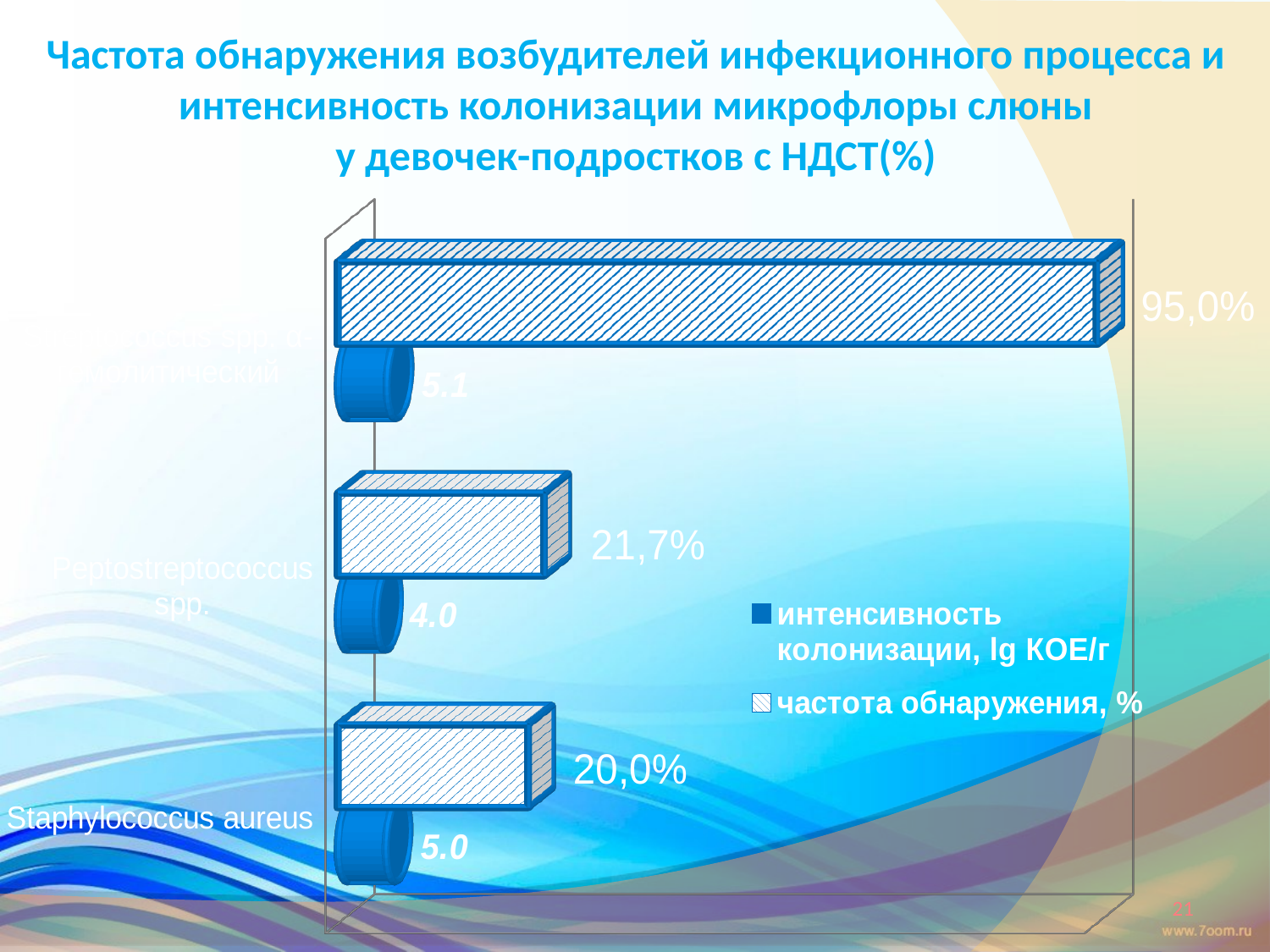
What is the difference in частота обнаружения, % between Peptostreptococcus spp. and Staphylococcus aureus? 1,7% What is the частота обнаружения, % value for the topmost category in the chart? 95,0% What is the частота обнаружения, % value for Peptostreptococcus spp.? 21,7% What is the интенсивность колонизации, lg КОЕ/г value for Staphylococcus aureus? 5.0 Which category has the lowest интенсивность колонизации, lg КОЕ/г? Peptostreptococcus spp. Which is larger: the интенсивность колонизации, lg КОЕ/г for Staphylococcus aureus or for Peptostreptococcus spp.? Staphylococcus aureus What is the интенсивность колонизации, lg КОЕ/г value for Peptostreptococcus spp.? 4.0 How many categories are plotted in the chart? 3 What kind of chart is shown on the slide? bar chart What is the частота обнаружения, % value for Staphylococcus aureus? 20,0% How many series does the legend list? 2 Which category has the lowest частота обнаружения, %? Staphylococcus aureus